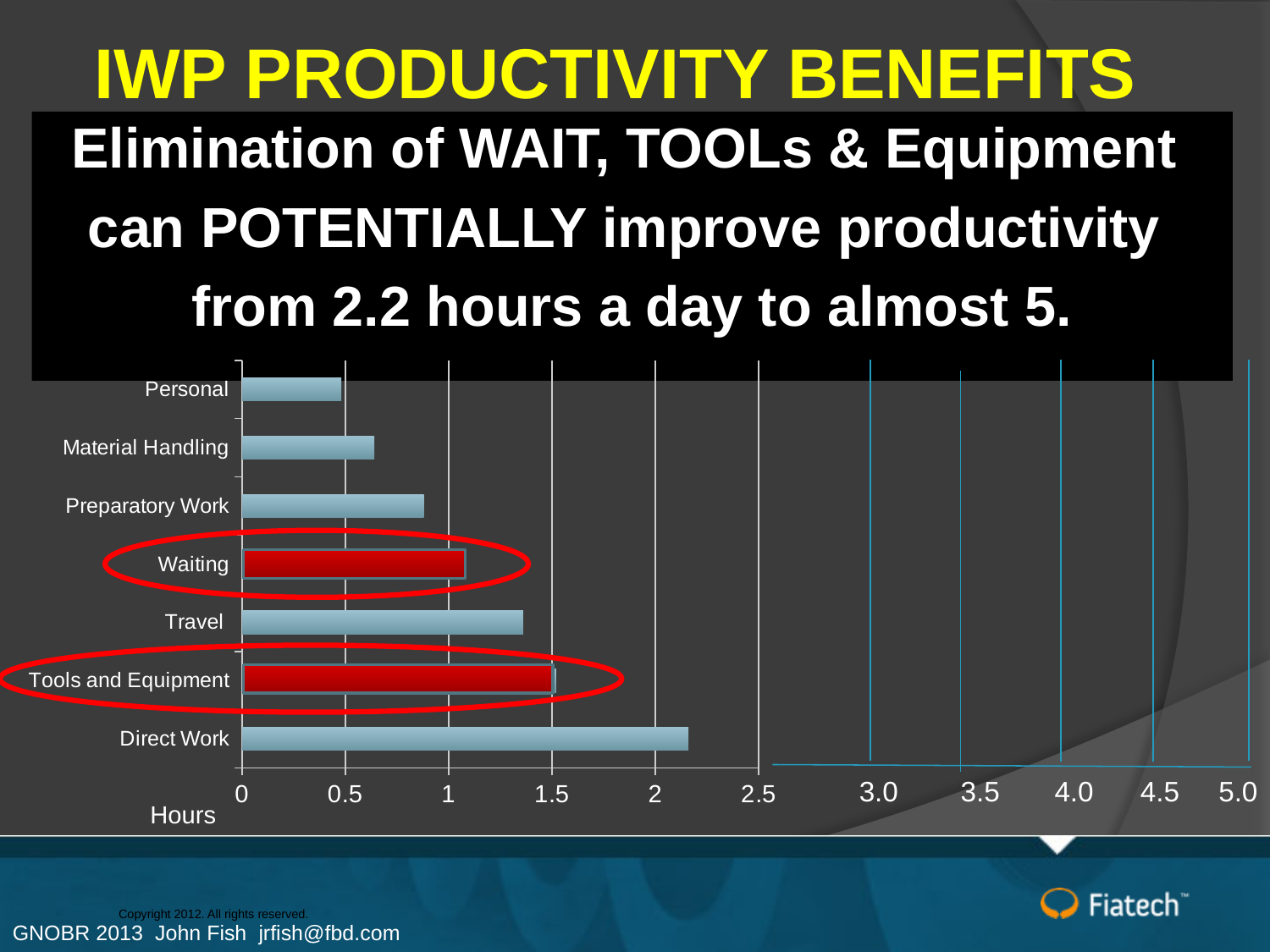
What is the label of the horizontal axis of the chart? Hours Which category has the shortest bar in the chart? Personal Is the value for Travel greater or less than 1.5 hours? less Is the value for Preparatory Work greater or less than 1 hour? less Which category has the longest bar in the chart? Direct Work Is the value for Direct Work greater or less than 2 hours? greater How many categories are plotted in the chart? 7 Which is larger, the value for Travel or the value for Waiting? Travel Which two categories are shown with red bars and circled in the chart? Waiting and Tools and Equipment What kind of chart is shown on the slide? Bar chart